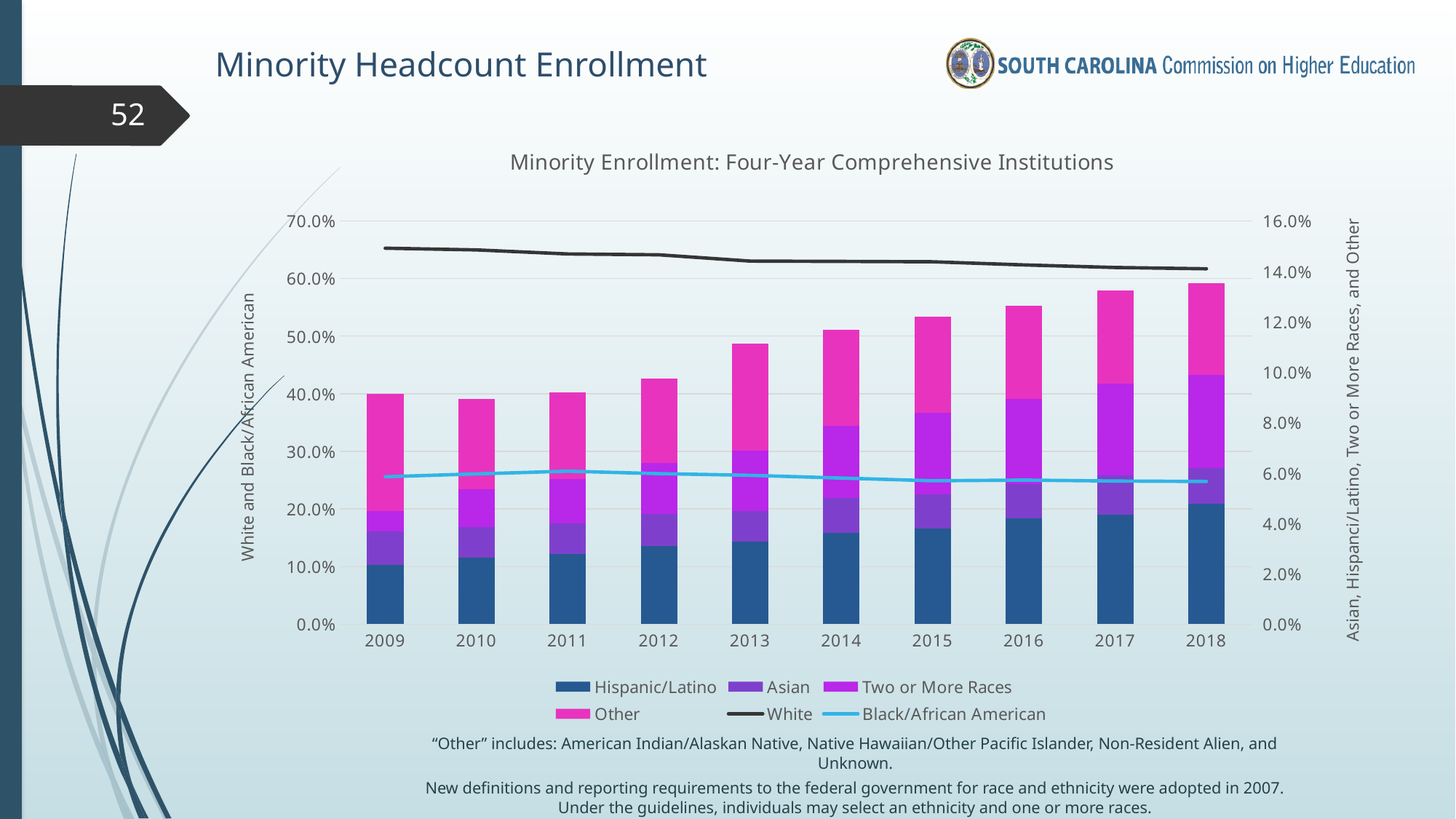
What kind of chart is shown on the slide? Combination stacked bar and line chart Read on the left-hand axis, is the White value for 2009 greater or less than 60.0%? greater Read on the right-hand axis, is the total stacked bar for 2009 greater or less than 10.0%? less Read on the right-hand axis, is the total stacked bar for 2018 greater or less than 12.0%? greater Does the White line rise or fall from 2009 to 2018? Fall Which is larger, the Hispanic/Latino segment in 2009 or in 2018? 2018 How many series does the chart legend list? 6 What is the title of the chart? Minority Enrollment: Four-Year Comprehensive Institutions Do the stacked bar totals generally rise or fall from 2009 to 2018? Rise How many years are shown along the x axis of the chart? 10 Which year has the tallest stacked bar in the chart? 2018